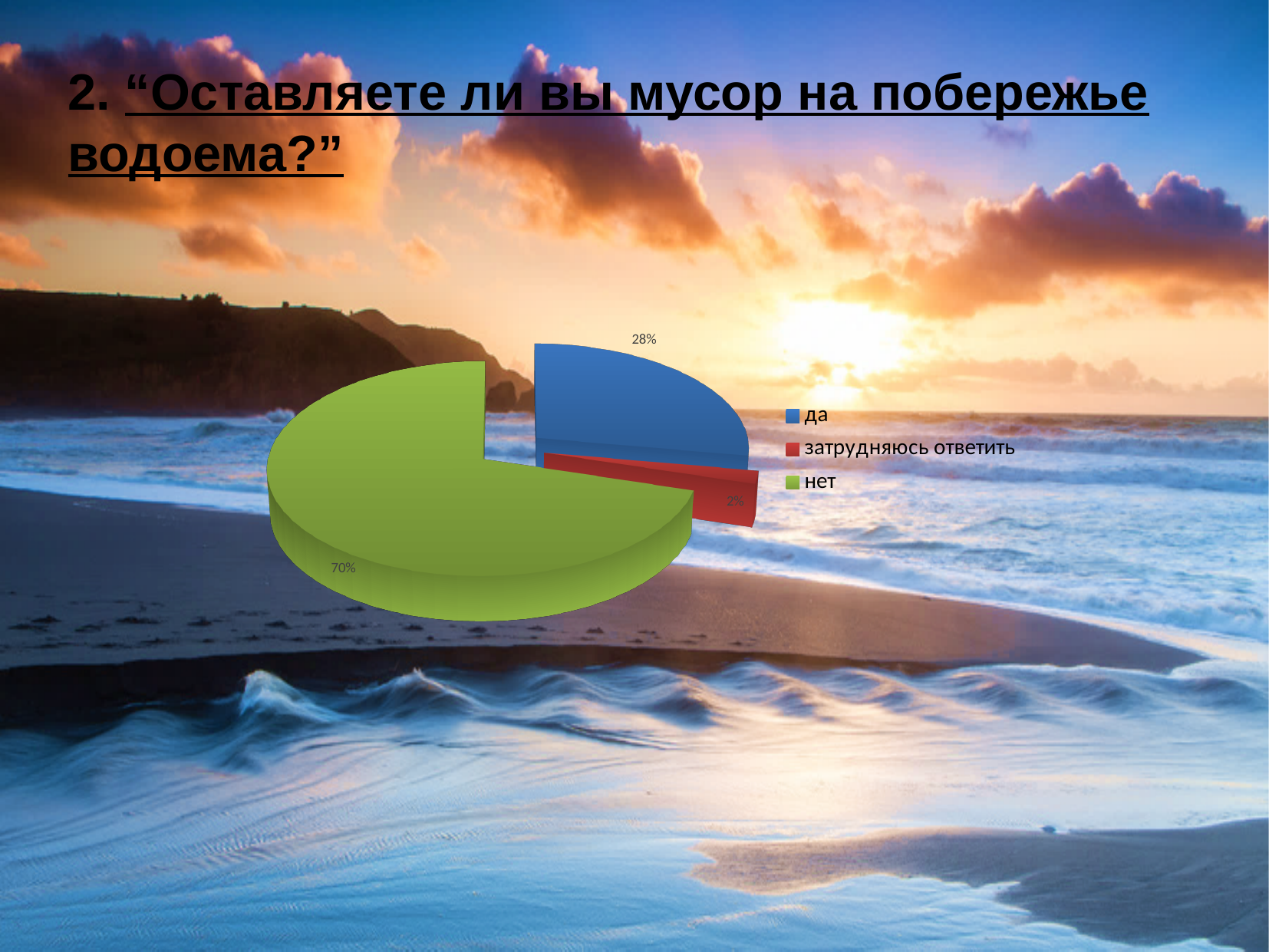
What kind of chart is shown on the slide? pie chart What share of the pie does the "затрудняюсь ответить" slice represent? 2% What share of the pie does the "да" slice represent? 28% Which category has the largest slice of the pie? нет How many slices does the pie chart have? 3 What colour is the "нет" slice in the pie chart? green What share of the pie does the "нет" slice represent? 70% What question is given in the slide title above the chart? Оставляете ли вы мусор на побережье водоема? What is the difference in percentage points between the "нет" slice and the "да" slice? 42 Which is larger, the "да" slice or the "затрудняюсь ответить" slice? да Which category has the smallest slice of the pie? затрудняюсь ответить How many entries does the legend list? 3